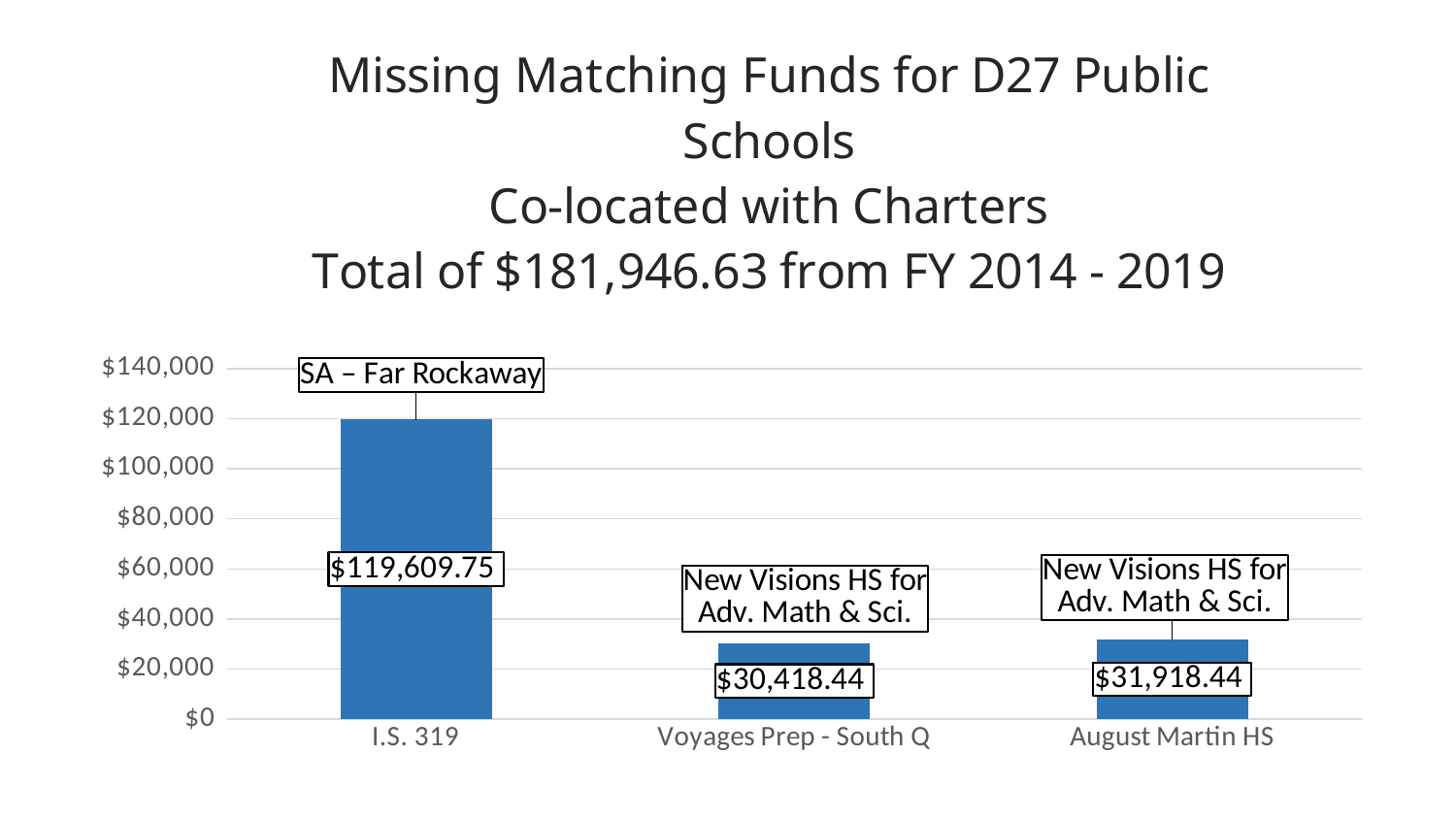
Which charter school is labelled above the bar for I.S. 319? SA – Far Rockaway What is the difference between the values for August Martin HS and Voyages Prep - South Q? $1,500.00 What is the difference between the values for I.S. 319 and Voyages Prep - South Q? $89,191.31 Which school has the lowest missing matching funds? Voyages Prep - South Q What kind of chart is shown on the slide? bar chart What is the value for August Martin HS? $31,918.44 Is the value for I.S. 319 greater or less than $100,000? greater How many schools are shown on the chart? 3 What is the value for Voyages Prep - South Q? $30,418.44 Which school has the highest missing matching funds? I.S. 319 Which is larger, the value for August Martin HS or the value for Voyages Prep - South Q? August Martin HS What is the value for I.S. 319? $119,609.75